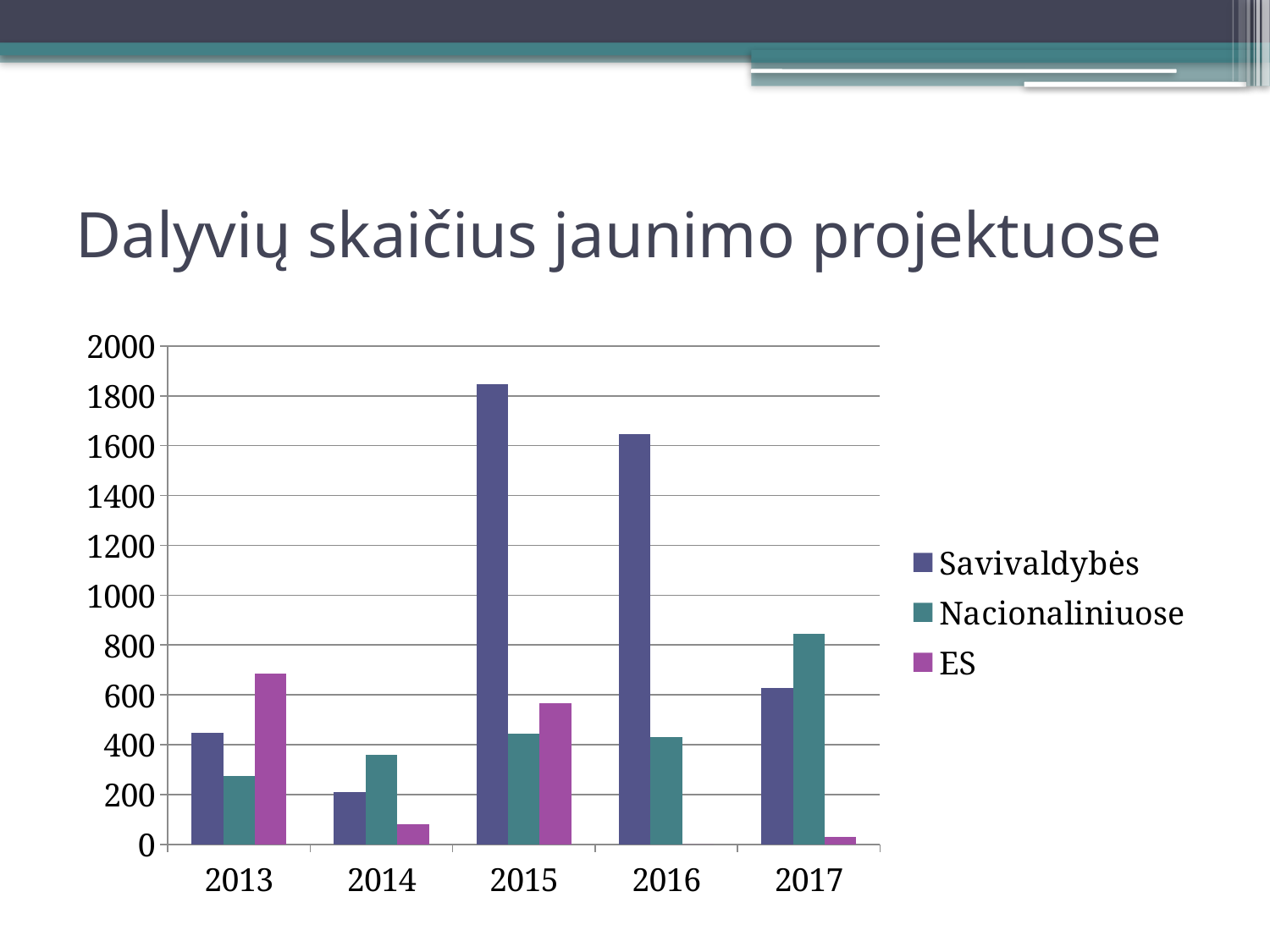
In which year is the Savivaldybės value lowest? 2014 In 2013, which is larger: ES or Savivaldybės? ES Is the Savivaldybės value for 2015 greater or less than 1600? greater How many series does the legend list? 3 How many years are shown on the x axis? 5 In which year is the Savivaldybės value highest? 2015 In 2017, which is larger: Savivaldybės or Nacionaliniuose? Nacionaliniuose What is the title of the slide above the chart? Dalyvių skaičius jaunimo projektuose Is the ES value for 2013 greater or less than 600? greater Is the Nacionaliniuose value for 2014 greater or less than 400? less What kind of chart is shown on the slide? bar chart In which year is the Nacionaliniuose value highest? 2017